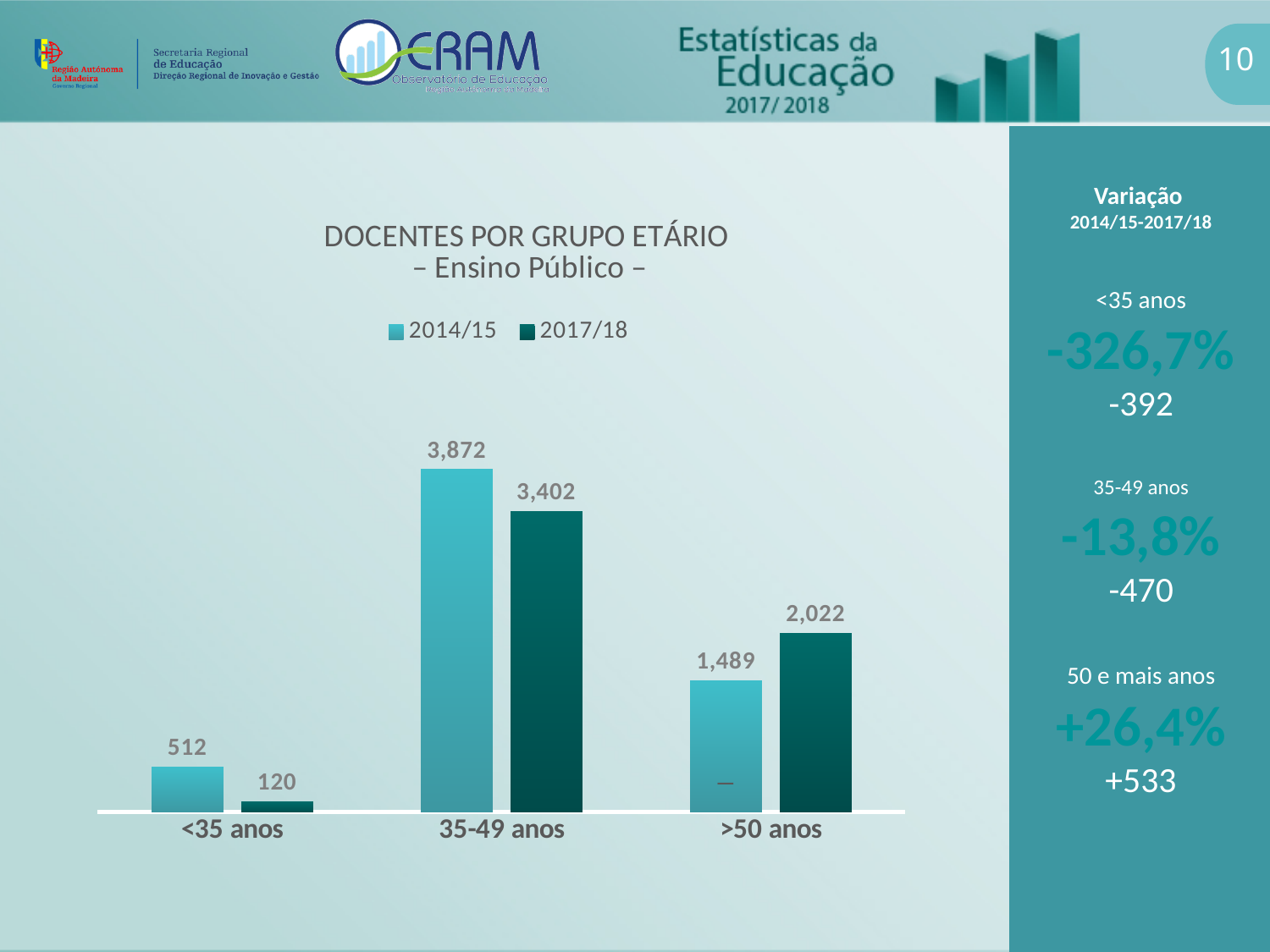
What is the value for <35 anos in the 2014/15 series? 512 Which age group has the lowest value in the 2017/18 series? <35 anos How many series does the legend list? 2 What is the value for 35-49 anos in the 2017/18 series? 3,402 What is the difference between the 2017/18 and 2014/15 values for >50 anos? 533 How many age groups are shown on the x axis? 3 Which age group has the highest value in the 2014/15 series? 35-49 anos What is the difference between the 2014/15 and 2017/18 values for 35-49 anos? 470 Which is larger for >50 anos: the 2014/15 value or the 2017/18 value? 2017/18 What is the value for <35 anos in the 2017/18 series? 120 What kind of chart is shown on the slide? Bar chart What is the value for >50 anos in the 2014/15 series? 1,489